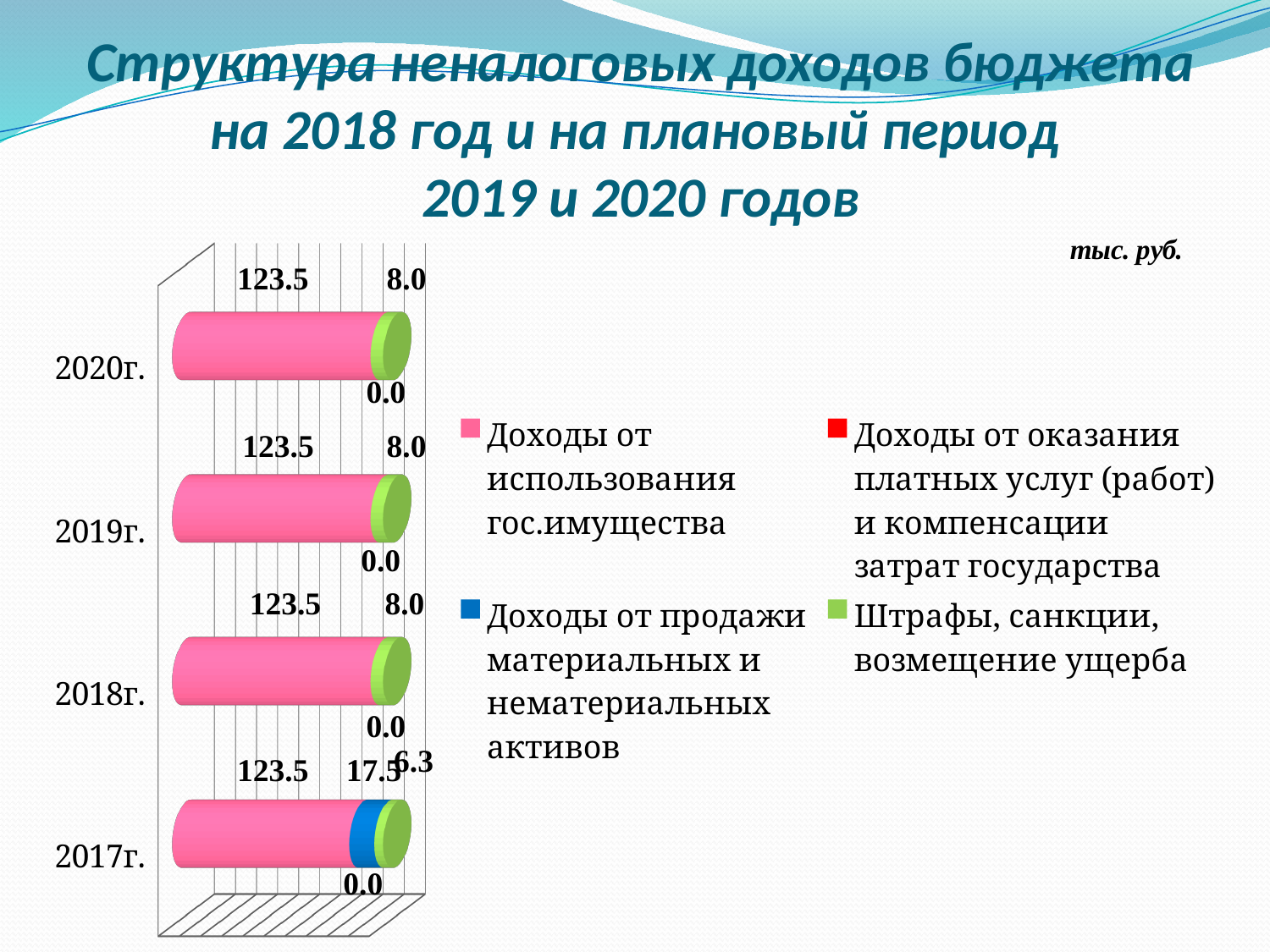
By how much does 'Штрафы, санкции, возмещение ущерба' in 2019г. exceed its value in 2017г.? 1.7 What is the value for 'Доходы от использования гос.имущества' in 2020г.? 123.5 How many series does the chart legend list? 4 What unit is indicated for the chart values? тыс. руб. In 2017г., which is larger: 'Доходы от продажи материальных и нематериальных активов' or 'Штрафы, санкции, возмещение ущерба'? Доходы от продажи материальных и нематериальных активов What is the value for 'Штрафы, санкции, возмещение ущерба' in 2017г.? 6.3 How many years (categories) are shown on the chart? 4 What is the total of the stacked bar for 2017г.? 147.3 In 2017г., what is the difference between 'Доходы от продажи материальных и нематериальных активов' and 'Штрафы, санкции, возмещение ущерба'? 11.2 What kind of chart is shown on the slide? Bar chart What is the value for 'Штрафы, санкции, возмещение ущерба' in 2019г.? 8.0 What is the value for 'Доходы от продажи материальных и нематериальных активов' in 2017г.? 17.5